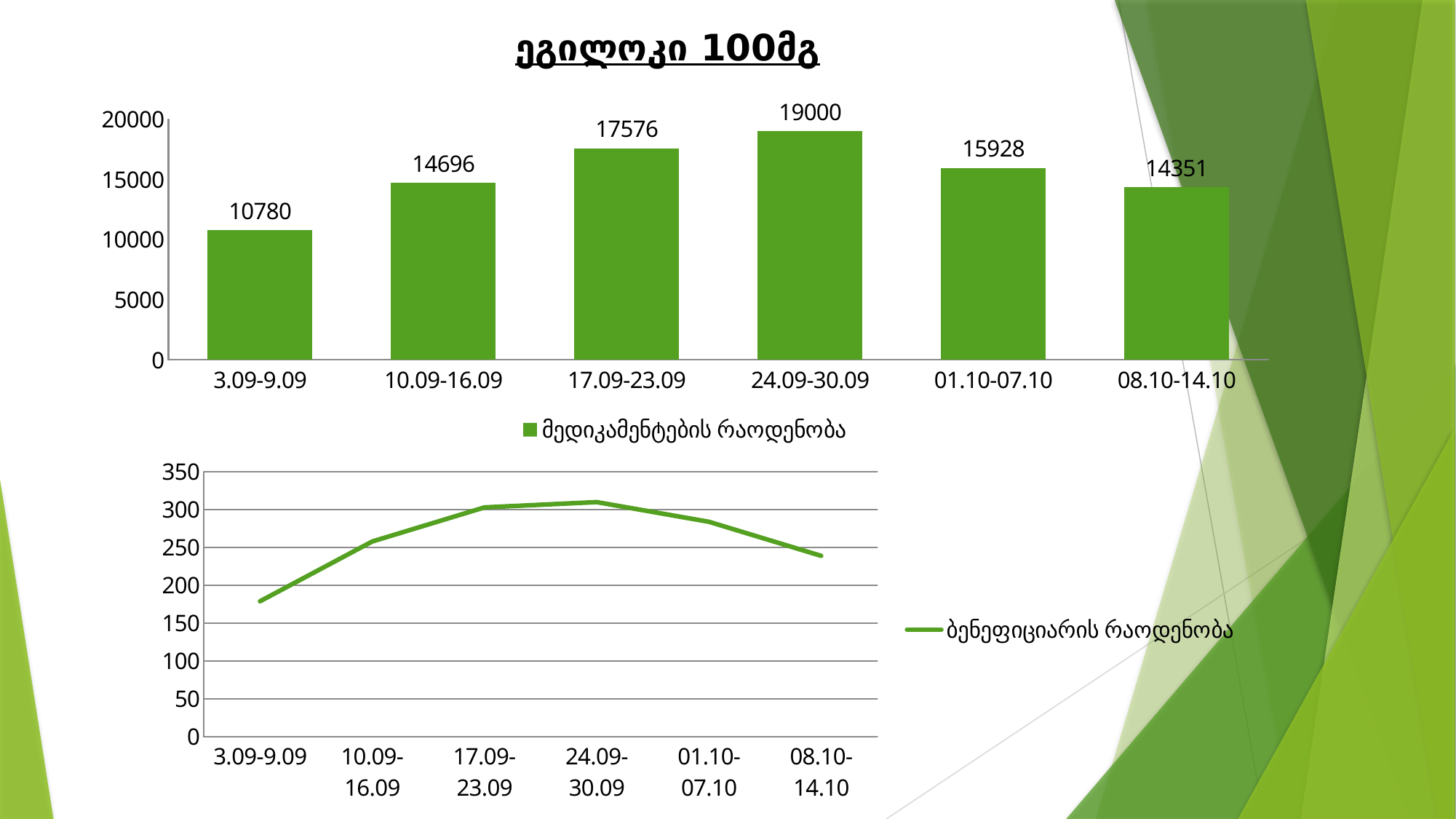
In the top bar chart, what is the difference between the values for 24.09-30.09 and 3.09-9.09? 8220 In the bottom line chart, is the value for 3.09-9.09 greater or less than 200? less In the top bar chart, which is larger: the value for 10.09-16.09 or the value for 08.10-14.10? 10.09-16.09 What is the legend entry of the bottom line chart? ბენეფიციარის რაოდენობა In the top bar chart, what is the value for 3.09-9.09? 10780 In the top bar chart, which period has the lowest value? 3.09-9.09 In the top bar chart, which period has the highest value? 24.09-30.09 What type of chart is the bottom chart on the slide? line chart In the bottom line chart, is the value for 17.09-23.09 greater or less than 250? greater In the top bar chart, what is the value for 01.10-07.10? 15928 In the top bar chart, what is the value for 24.09-30.09? 19000 How many bars are in the top bar chart? 6